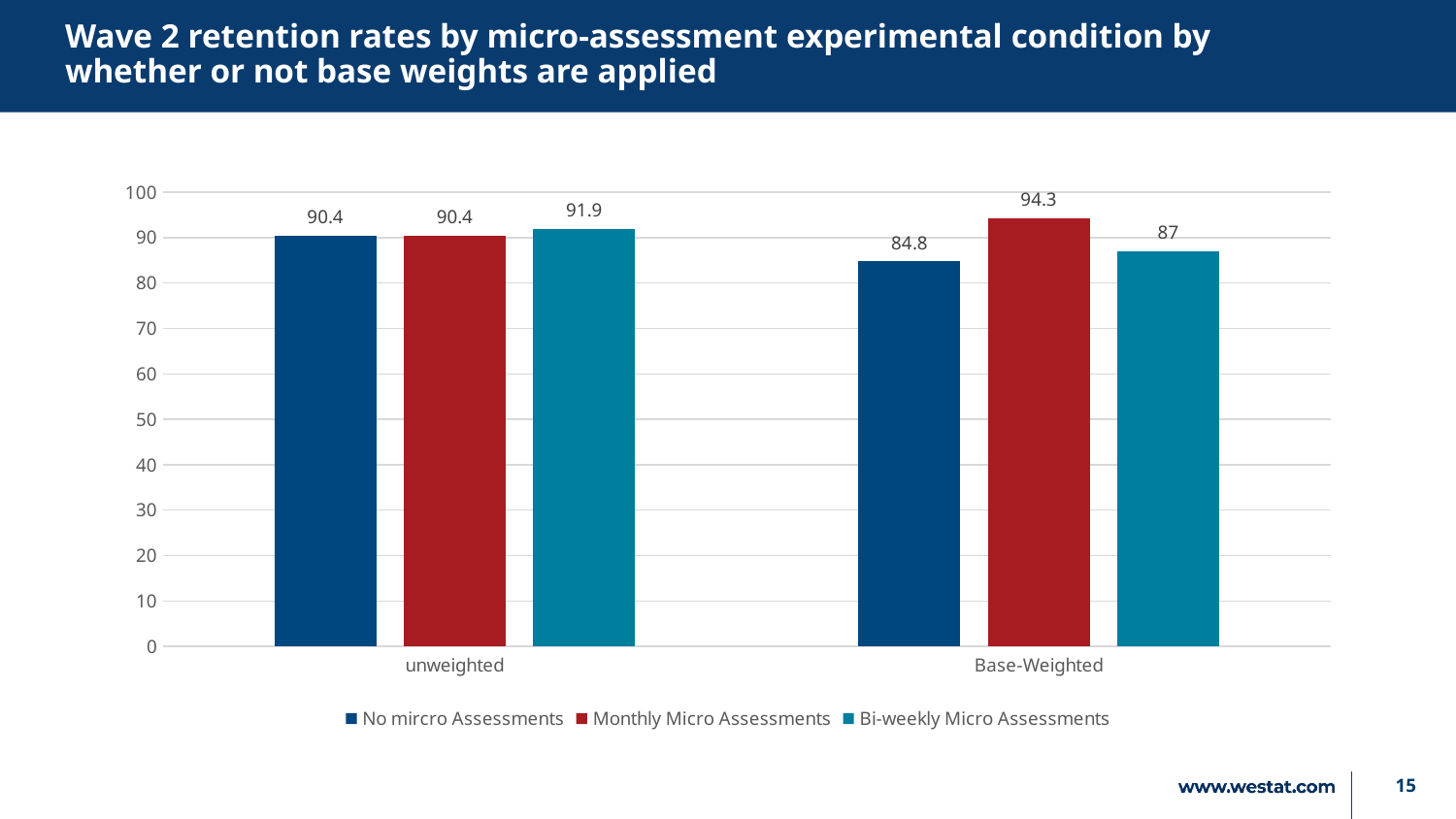
What is the difference between the Monthly Micro Assessments and No mircro Assessments retention rates in the Base-Weighted group? 9.5 What is the retention rate for Bi-weekly Micro Assessments in the Base-Weighted group? 87 What is the retention rate for No mircro Assessments in the unweighted group? 90.4 What kind of chart is shown on the slide? Bar chart Which is larger: the Bi-weekly Micro Assessments rate in the unweighted group or in the Base-Weighted group? unweighted What is the Wave 2 retention rate for Monthly Micro Assessments in the Base-Weighted group? 94.3 Which series has the highest retention rate in the Base-Weighted group? Monthly Micro Assessments How many series does the legend list? 3 What is the difference between the Bi-weekly Micro Assessments retention rate in the unweighted group and in the Base-Weighted group? 4.9 How many categories are shown on the x axis? 2 Is the value for No mircro Assessments in the Base-Weighted group greater or less than 90? less Which series has the lowest retention rate in the Base-Weighted group? No mircro Assessments